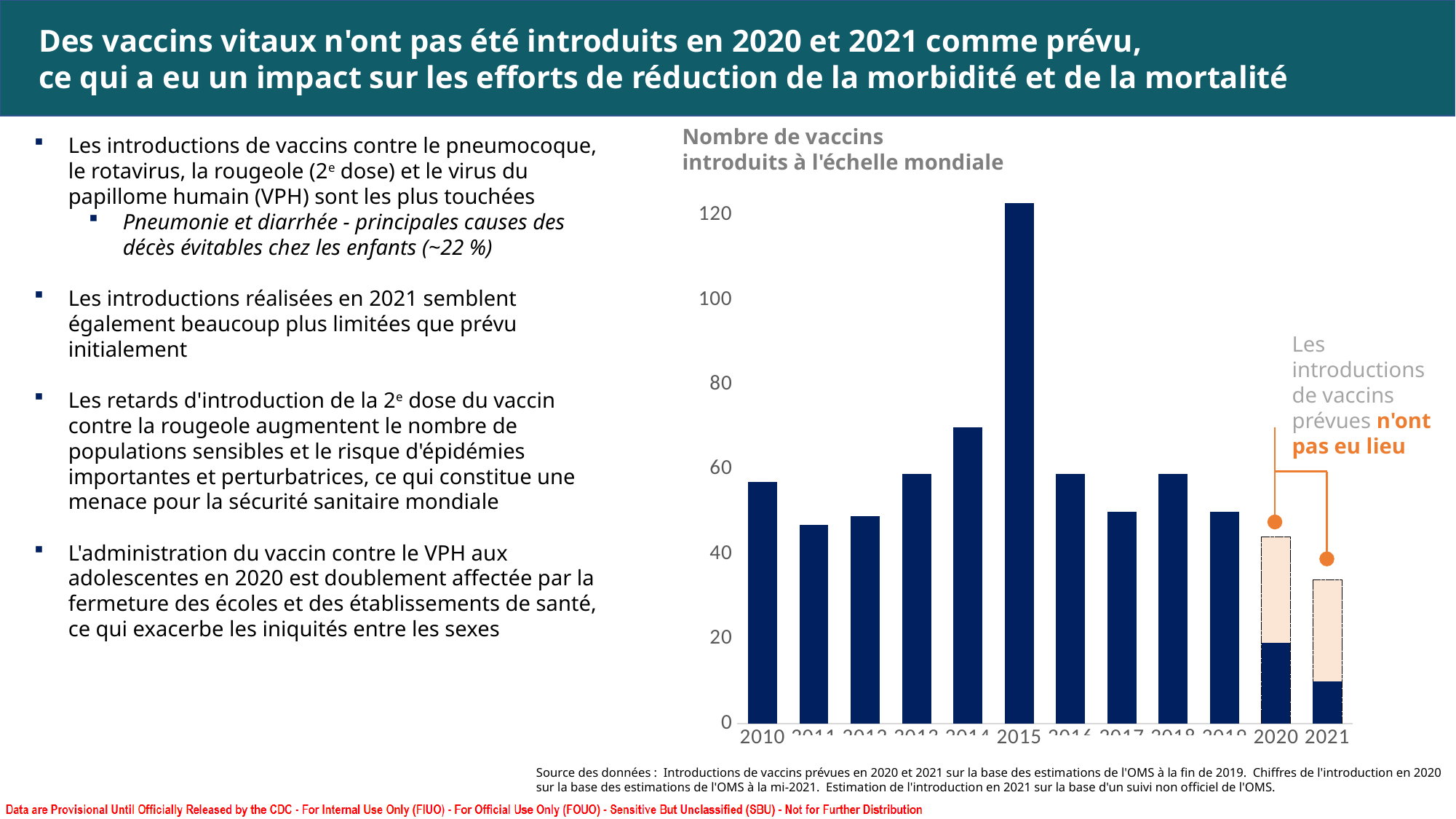
Is the value for 2015 greater or less than 100? greater Which year has the highest number of vaccine introductions? 2015 Which year has more actual vaccine introductions (dark bar), 2020 or 2021? 2020 Do the actual introductions rise or fall from 2019 to 2021? Fall Is the actual (dark bar) value for 2021 greater or less than 20? less How many years are shown on the x axis of the chart? 12 Is the value for 2010 greater or less than 60? less What do the light outlined portions of the 2020 and 2021 bars represent? Planned vaccine introductions that did not take place What kind of chart is shown on the slide? Bar chart Which year has the lowest number of actual vaccine introductions (dark bar)? 2021 What is the title of the chart? Nombre de vaccins introduits à l'échelle mondiale